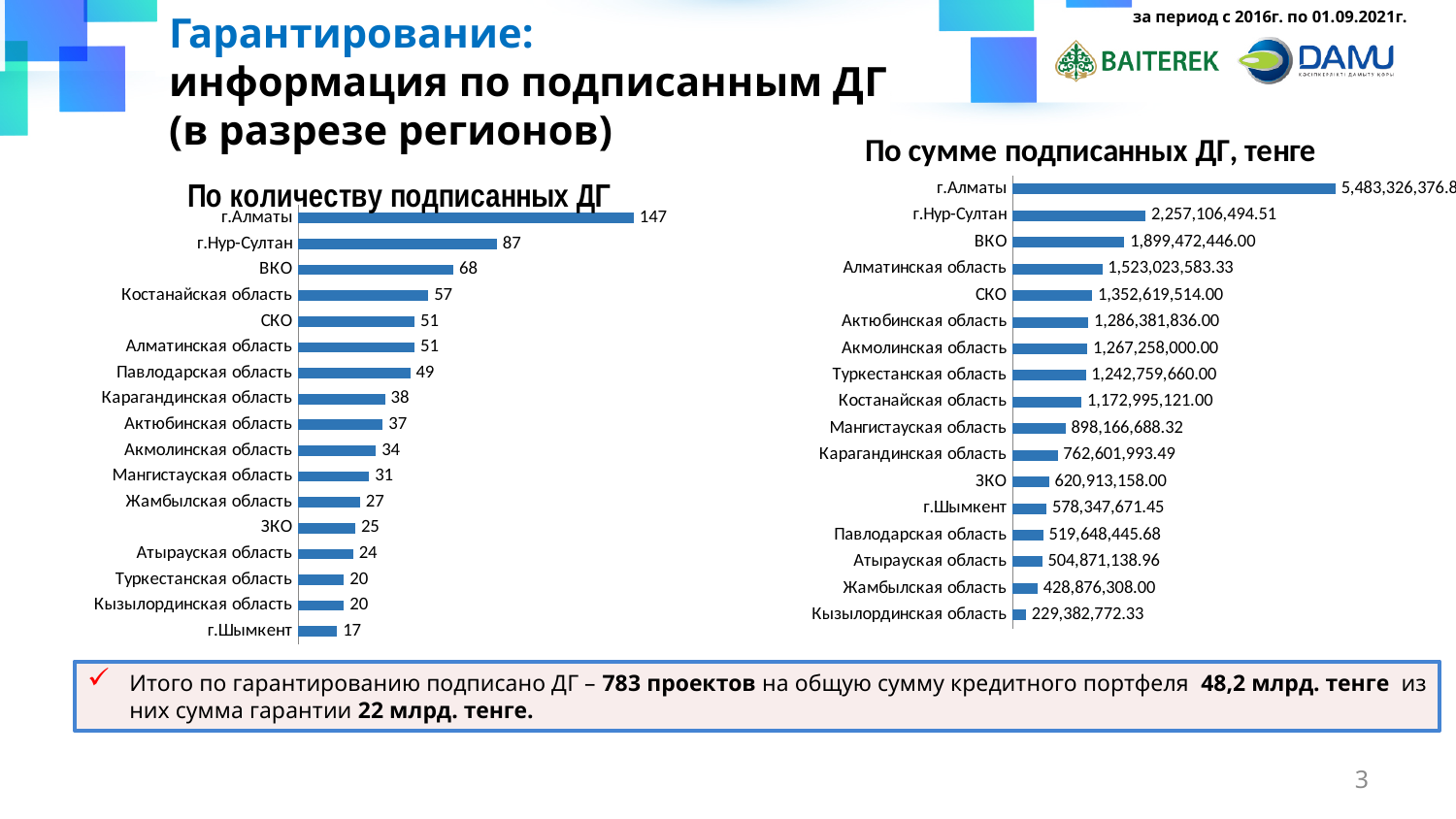
In the chart 'По количеству подписанных ДГ', how many categories are shown? 17 In the chart 'По количеству подписанных ДГ', which is larger: Костанайская область or СКО? Костанайская область In the chart 'По количеству подписанных ДГ', what is the difference between the values for г.Алматы and ВКО? 79 In the chart 'По сумме подписанных ДГ, тенге', which region has the lowest value? Кызылординская область In the chart 'По сумме подписанных ДГ, тенге', which is larger: Мангистауская область or Карагандинская область? Мангистауская область In the chart 'По количеству подписанных ДГ', which category has the lowest value? г.Шымкент In the chart 'По сумме подписанных ДГ, тенге', what is the value for г.Шымкент? 578,347,671.45 In the chart 'По количеству подписанных ДГ', which region has the highest value? г.Алматы What type of chart is 'По сумме подписанных ДГ, тенге'? Bar chart In the chart 'По сумме подписанных ДГ, тенге', what is the value for ВКО? 1,899,472,446.00 In the chart 'По количеству подписанных ДГ', what is the value for Павлодарская область? 49 In the chart 'По количеству подписанных ДГ', what is the value for г.Нур-Султан? 87